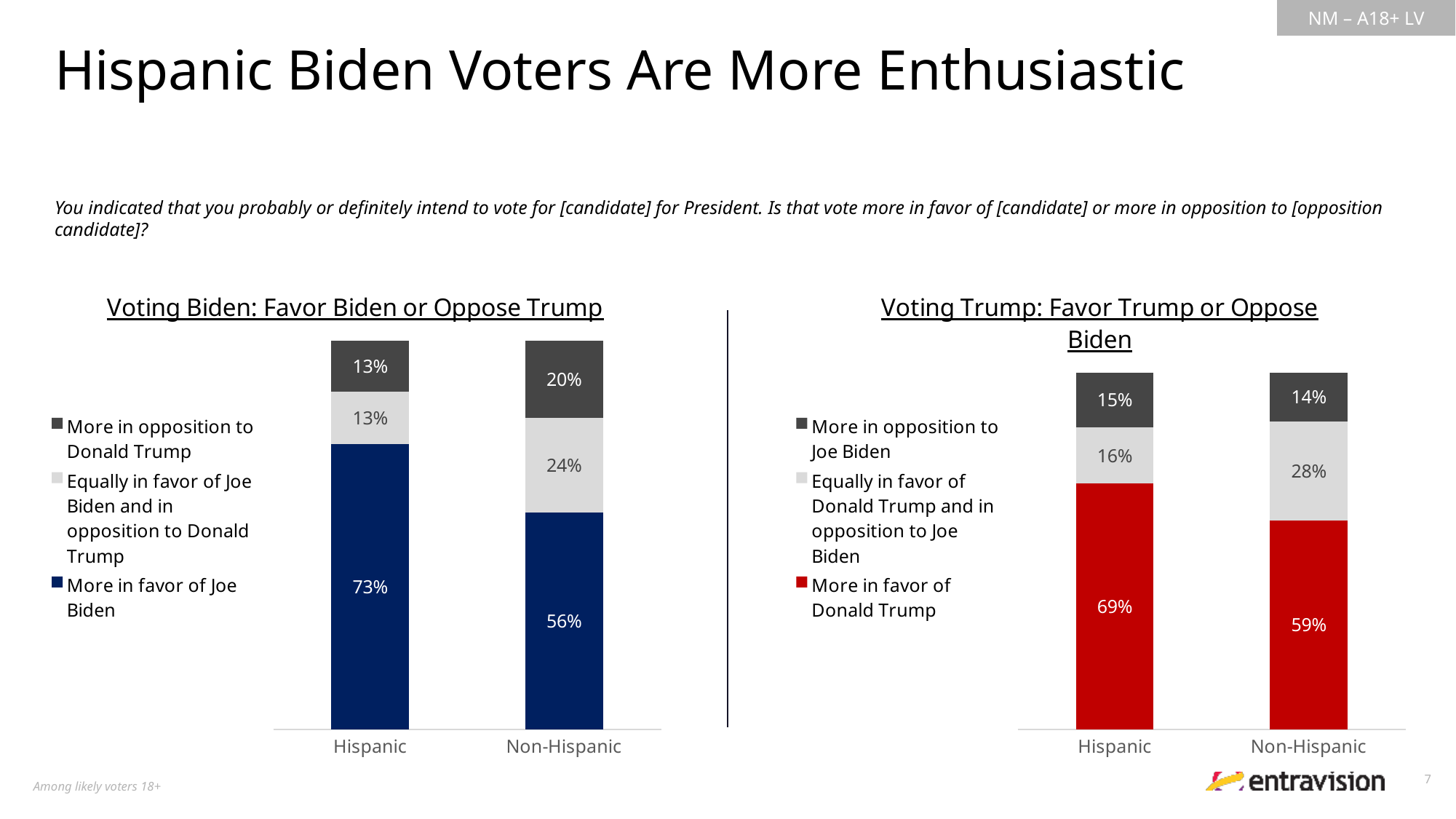
In the 'Voting Trump: Favor Trump or Oppose Biden' chart, what percentage of Hispanic voters are 'More in favor of Donald Trump'? 69% In the 'Voting Biden: Favor Biden or Oppose Trump' chart, what percentage of Hispanic voters are 'More in favor of Joe Biden'? 73% In the 'Voting Trump: Favor Trump or Oppose Biden' chart, what colour represents 'More in favor of Donald Trump'? Red How many series does the legend of the 'Voting Trump: Favor Trump or Oppose Biden' chart list? 3 In the 'Voting Trump: Favor Trump or Oppose Biden' chart, which group has the larger value for 'More in favor of Donald Trump', Hispanic or Non-Hispanic? Hispanic How many categories are shown on the x axis of the 'Voting Biden: Favor Biden or Oppose Trump' chart? 2 In the 'Voting Biden: Favor Biden or Oppose Trump' chart, which group has the larger value for 'More in opposition to Donald Trump', Hispanic or Non-Hispanic? Non-Hispanic In the 'Voting Biden: Favor Biden or Oppose Trump' chart, what is the difference between the Hispanic and Non-Hispanic values for 'More in favor of Joe Biden'? 17% In the 'Voting Trump: Favor Trump or Oppose Biden' chart, what is the difference between the Non-Hispanic and Hispanic values for 'Equally in favor of Donald Trump and in opposition to Joe Biden'? 12% What kind of chart is the 'Voting Biden: Favor Biden or Oppose Trump' chart? Stacked bar chart In the 'Voting Biden: Favor Biden or Oppose Trump' chart, what percentage of Non-Hispanic voters are 'More in opposition to Donald Trump'? 20% In the 'Voting Trump: Favor Trump or Oppose Biden' chart, what percentage of Non-Hispanic voters are 'Equally in favor of Donald Trump and in opposition to Joe Biden'? 28%